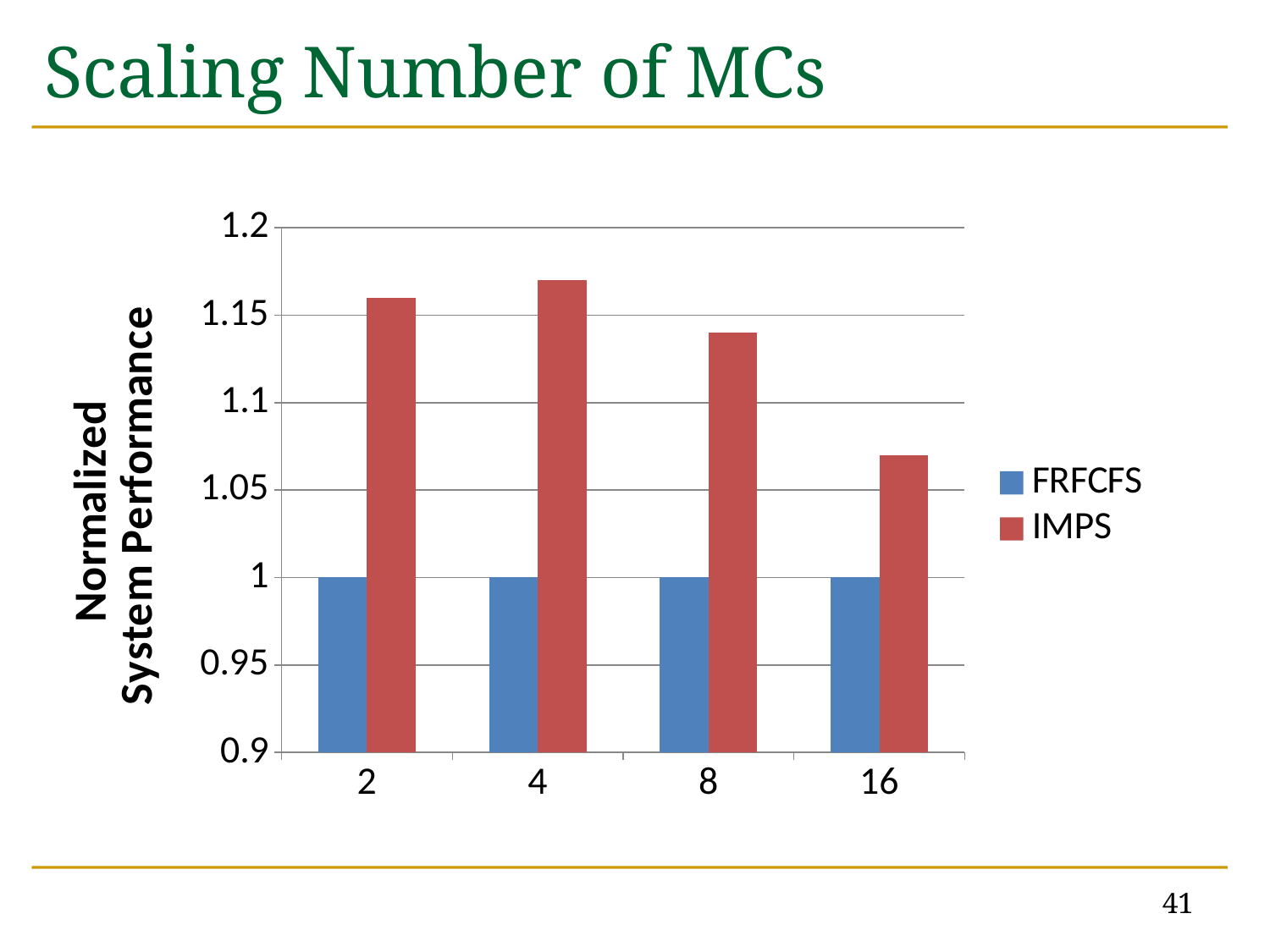
Which is larger at 16 MCs, the FRFCFS value or the IMPS value? IMPS How many categories are shown on the x axis? 4 How many series does the legend list? 2 Is the IMPS value for 4 MCs greater or less than 1.15? greater What is the label on the y axis? Normalized System Performance For which number of MCs is the IMPS value lowest? 16 Does the IMPS value rise or fall from 8 MCs to 16 MCs? fall What kind of chart is shown on the slide? bar chart What is the FRFCFS value for 16 MCs? 1 Is the IMPS value for 16 MCs greater or less than 1.1? less What is the FRFCFS value for 8 MCs? 1 Is the IMPS value for 2 MCs greater or less than 1.1? greater